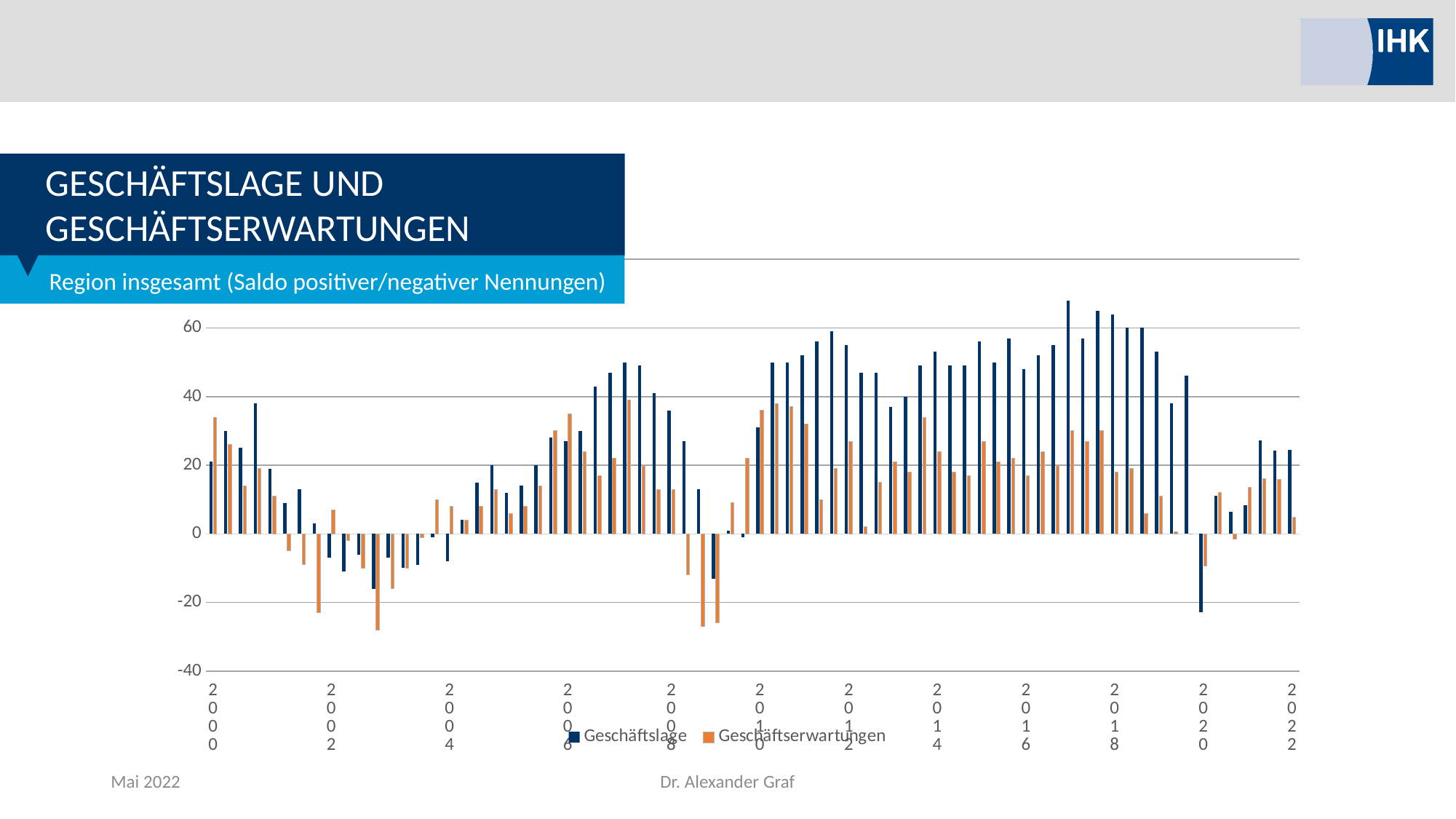
Is the highest Geschäftslage value on the chart greater or less than 60? greater Which series reaches the highest value anywhere on the chart? Geschäftslage How many year labels are shown on the x axis? 12 Between 2000 and 2003, do the Geschäftslage values generally rise or fall? fall What are the two series named in the legend? Geschäftslage and Geschäftserwartungen At the first data point (2000), which series has the larger value, Geschäftslage or Geschäftserwartungen? Geschäftserwartungen What kind of chart is shown on the slide? bar chart Which series is drawn in orange? Geschäftserwartungen Which series reaches the lowest value anywhere on the chart? Geschäftserwartungen Is the first Geschäftserwartungen value (at 2000) greater or less than 20? greater How many series does the legend list? 2 Is the lowest Geschäftserwartungen value on the chart greater or less than -20? less